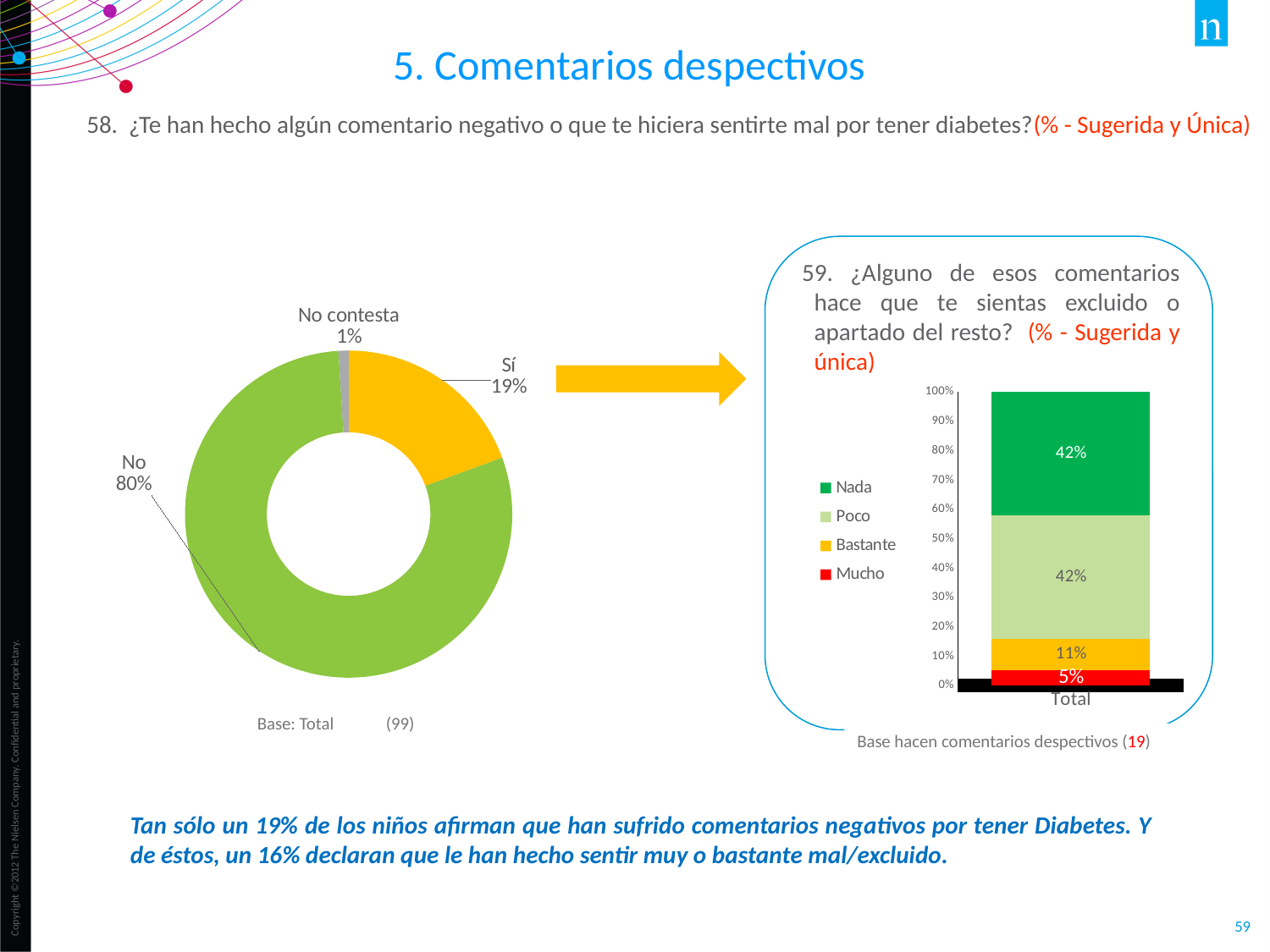
In the stacked bar chart on the right, what percentage is shown for "Bastante"? 11% In the donut chart on the left, which category has the smallest share? No contesta In the stacked bar chart on the right, what percentage is shown for "Poco"? 42% In the stacked bar chart on the right, what percentage is shown for "Mucho"? 5% In the donut chart on the left, what percentage is shown for "No contesta"? 1% In the donut chart on the left, what is the difference in percentage points between "No" and "Sí"? 61 In the donut chart on the left, which category has the largest share? No In the donut chart on the left, what percentage of respondents answered "No"? 80% How many series does the legend of the stacked bar chart on the right list? 4 How many categories does the donut chart on the left show? 3 In the stacked bar chart on the right, which is larger, the value for "Bastante" or the value for "Mucho"? Bastante In the donut chart on the left, what percentage of respondents answered "Sí"? 19%